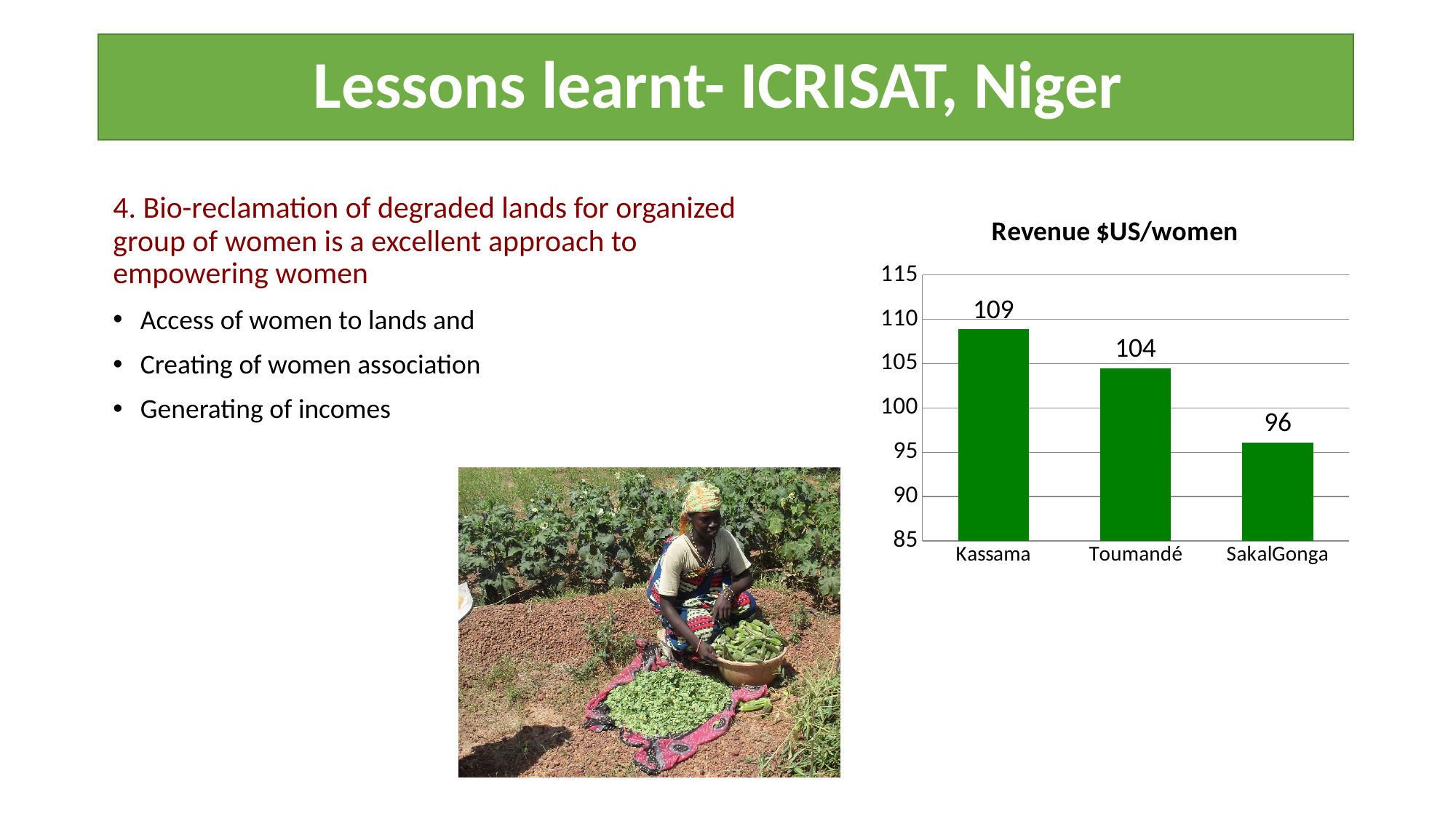
Which has a larger revenue, Toumandé or SakalGonga? Toumandé Which category has the lowest revenue? SakalGonga What is the revenue value for Kassama? 109 What is the revenue value for Toumandé? 104 What is the title of the chart? Revenue $US/women What is the difference between the revenue for Kassama and Toumandé? 5 What is the revenue value for SakalGonga? 96 How many categories are shown in the chart? 3 Which category has the highest revenue? Kassama Is the value for SakalGonga greater or less than 100? less What is the difference between the revenue for Toumandé and SakalGonga? 8 What kind of chart is shown on the slide? bar chart